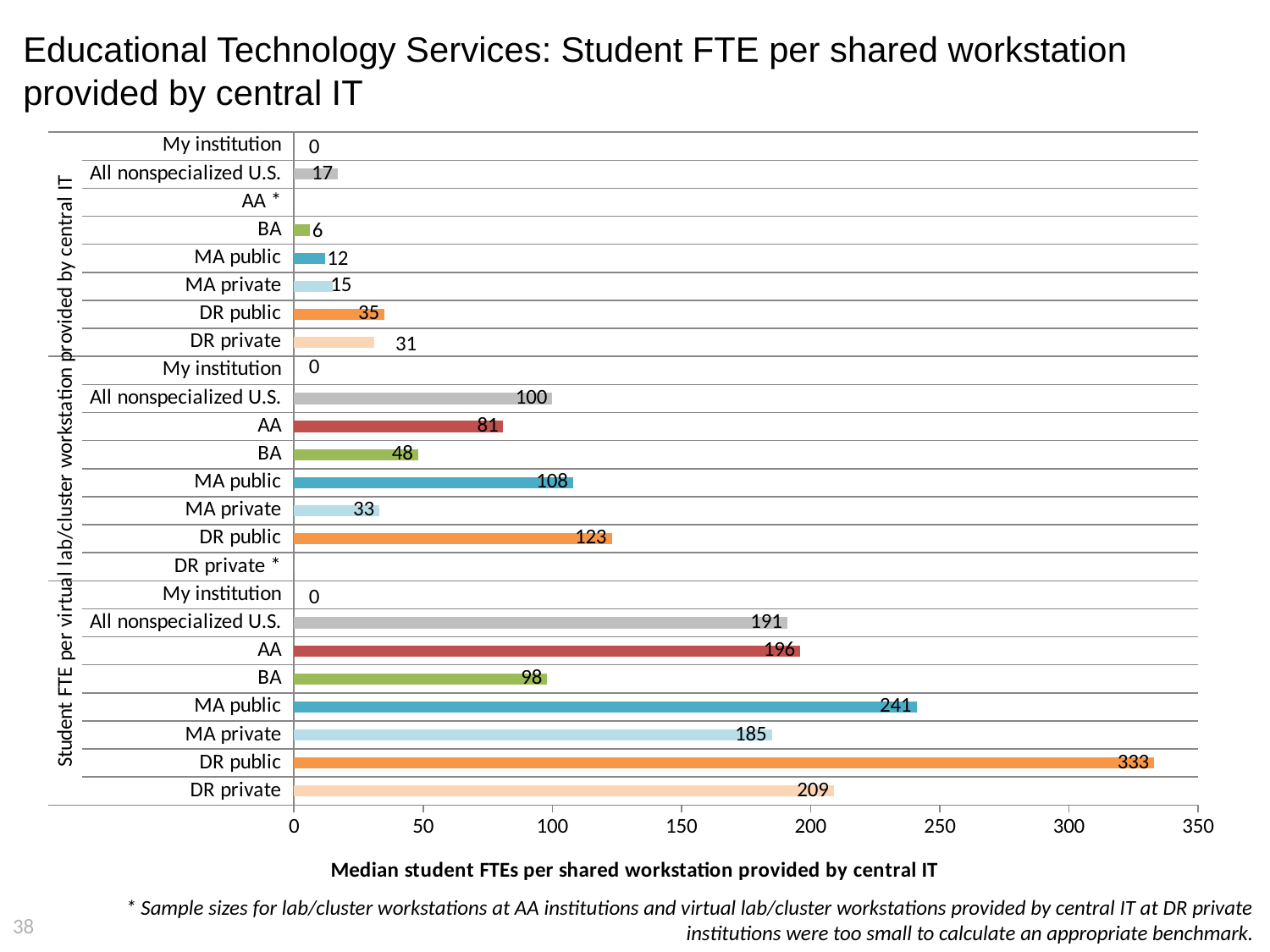
What type of chart is shown on the slide? bar chart What is the x-axis title of the chart? Median student FTEs per shared workstation provided by central IT What is the maximum value shown on the x axis? 350 In the bottom group of bars, what is the value for DR public? 333 In the bottom group of bars, is the value for AA greater or less than 150? greater In the top group of bars, what is the value for All nonspecialized U.S.? 17 In the middle group of bars, which is larger: DR public or All nonspecialized U.S.? DR public In the middle group of bars, what is the value for MA public? 108 In the top group of bars, what is the difference between DR public and DR private? 4 In the bottom group of bars, which category has the highest value? DR public In the middle group of bars, which labeled category has the lowest non-zero value? MA private In the bottom group of bars, what is the difference between MA public and MA private? 56